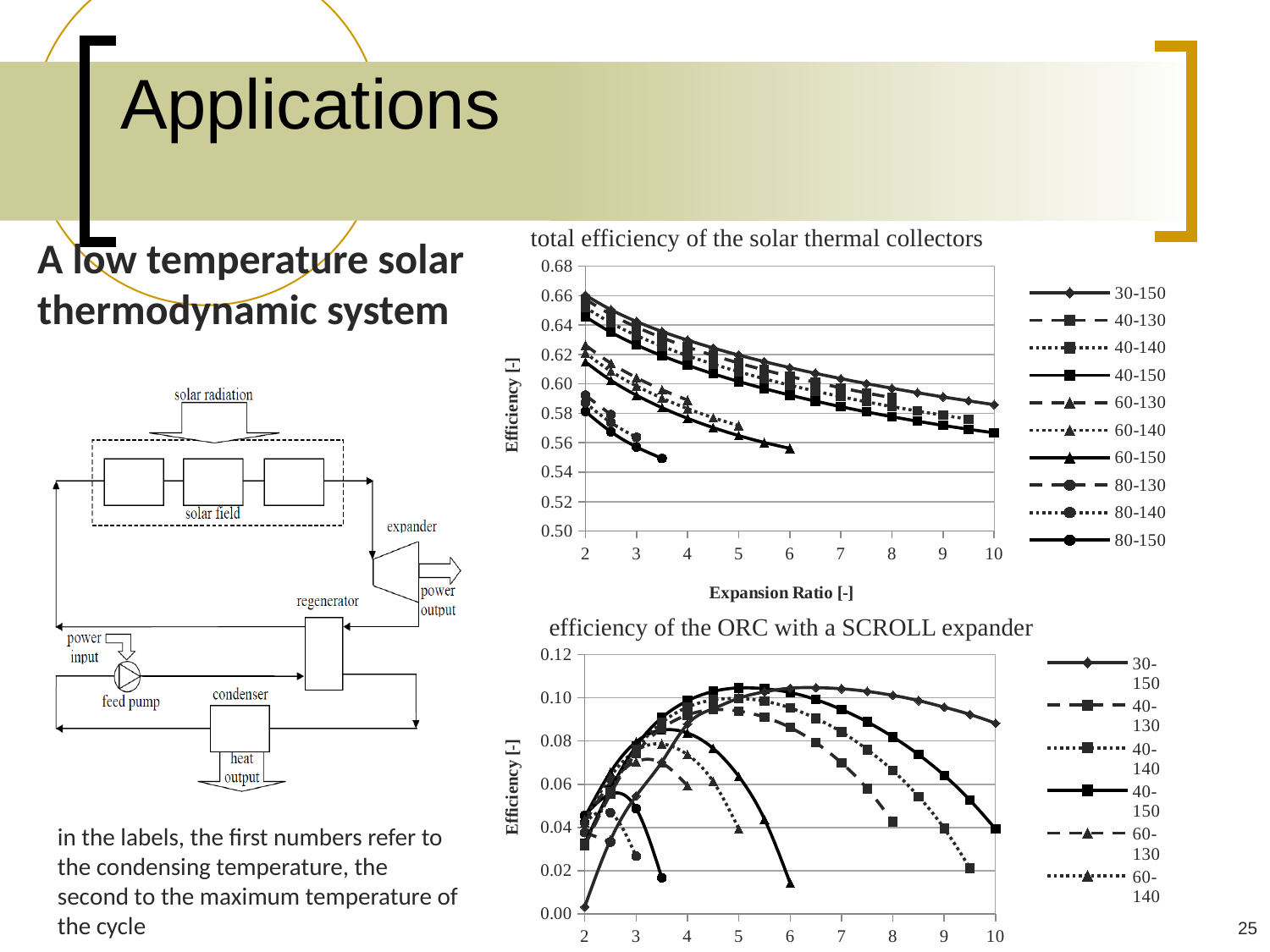
In the 'total efficiency of the solar thermal collectors' chart, does the 30-150 series rise or fall as the expansion ratio increases? fall In the 'total efficiency of the solar thermal collectors' chart, is the value of the 30-150 series at expansion ratio 2 greater or less than 0.64? greater What kind of chart is the 'total efficiency of the solar thermal collectors' chart? line chart What is the y-axis title of the 'efficiency of the ORC with a SCROLL expander' chart? Efficiency [-] In the 'total efficiency of the solar thermal collectors' chart, which series has the highest efficiency at expansion ratio 10? 30-150 In the 'total efficiency of the solar thermal collectors' chart, at expansion ratio 2, which series has the larger efficiency: 30-150 or 60-150? 30-150 In the 'total efficiency of the solar thermal collectors' chart, is the last point of the 80-150 series (at expansion ratio 3.5) greater or less than 0.56? less In the 'efficiency of the ORC with a SCROLL expander' chart, is the value of the 30-150 series at expansion ratio 10 greater or less than 0.08? greater What is the x-axis title of the 'total efficiency of the solar thermal collectors' chart? Expansion Ratio [-] What kind of chart is the 'efficiency of the ORC with a SCROLL expander' chart? line chart How many series does the legend of the 'total efficiency of the solar thermal collectors' chart list? 10